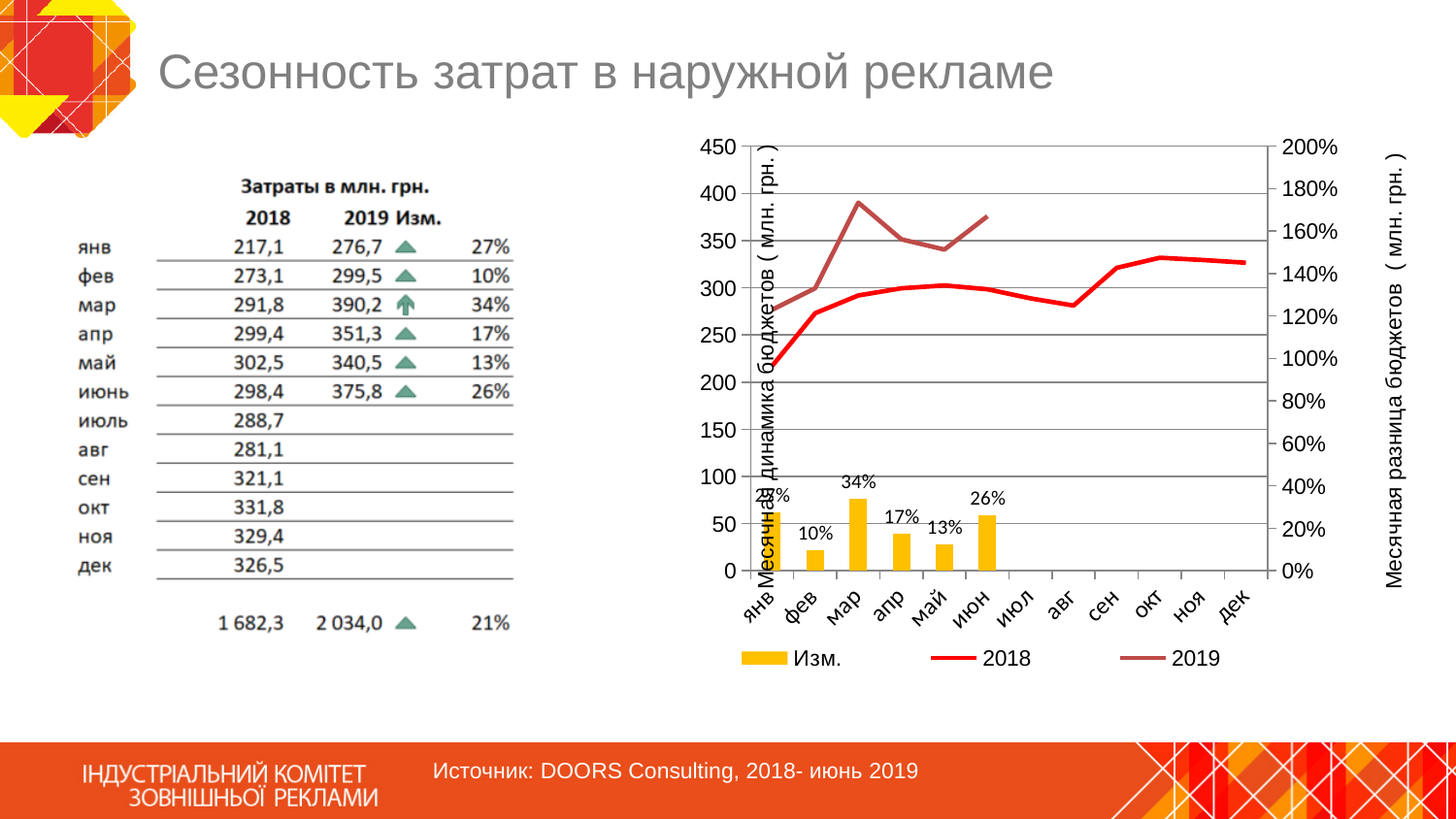
Is the 2019 line value for мар greater or less than 350? greater Which month has the larger Изм. value, апр or май? апр What kind of chart is shown on the right of the slide? A combined bar and line chart What is the Изм. value for мар in the chart? 34% Is the 2018 line value for янв greater or less than 250? less Does the 2019 line rise or fall from мар to май? fall What is the difference between the Изм. values for мар and фев? 24 percentage points Which month has the lowest Изм. bar in the chart? фев What is the Изм. value for июн in the chart? 26% Which month has the highest Изм. bar in the chart? мар What is the Изм. value for фев in the chart? 10% How many series does the chart legend list? 3